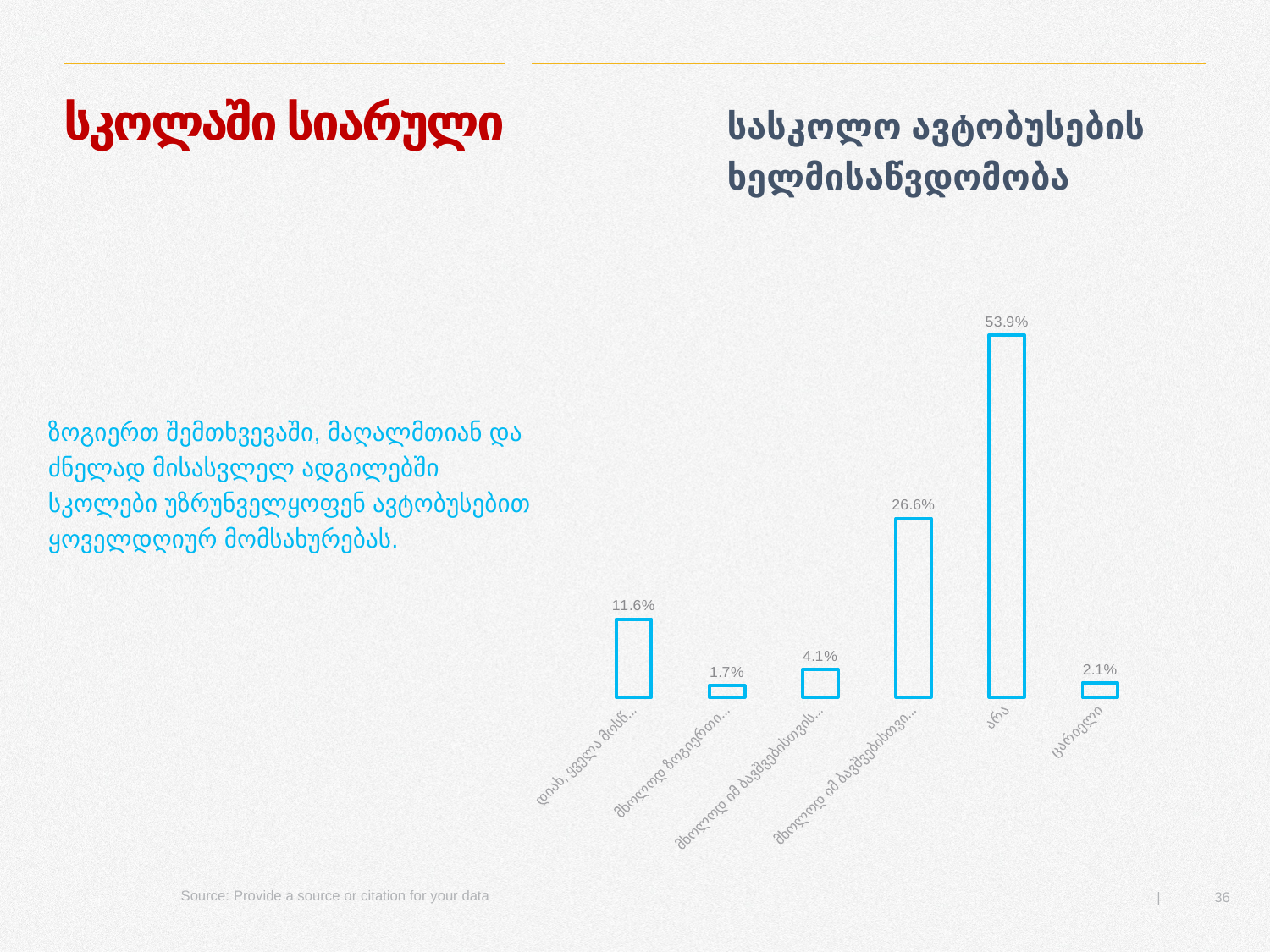
What is the value of the first (leftmost) bar in the chart? 11.6% What is the title of the chart on the slide? სასკოლო ავტობუსების ხელმისაწვდომობა What colour are the bars in the chart? blue What type of chart is shown on the slide? bar chart How many bars are plotted in the chart? 6 Which is larger: the third bar (4.1%) or the last bar (2.1%)? the third bar (4.1%) What is the value of the fourth bar from the left? 26.6% What is the value for the category "არა"? 53.9% What is the value of the highest bar in the chart? 53.9% What is the value of the lowest bar in the chart? 1.7% What is the difference between the highest bar (53.9%) and the fourth bar (26.6%)? 27.3% What is the difference between the first bar (11.6%) and the second bar (1.7%)? 9.9%